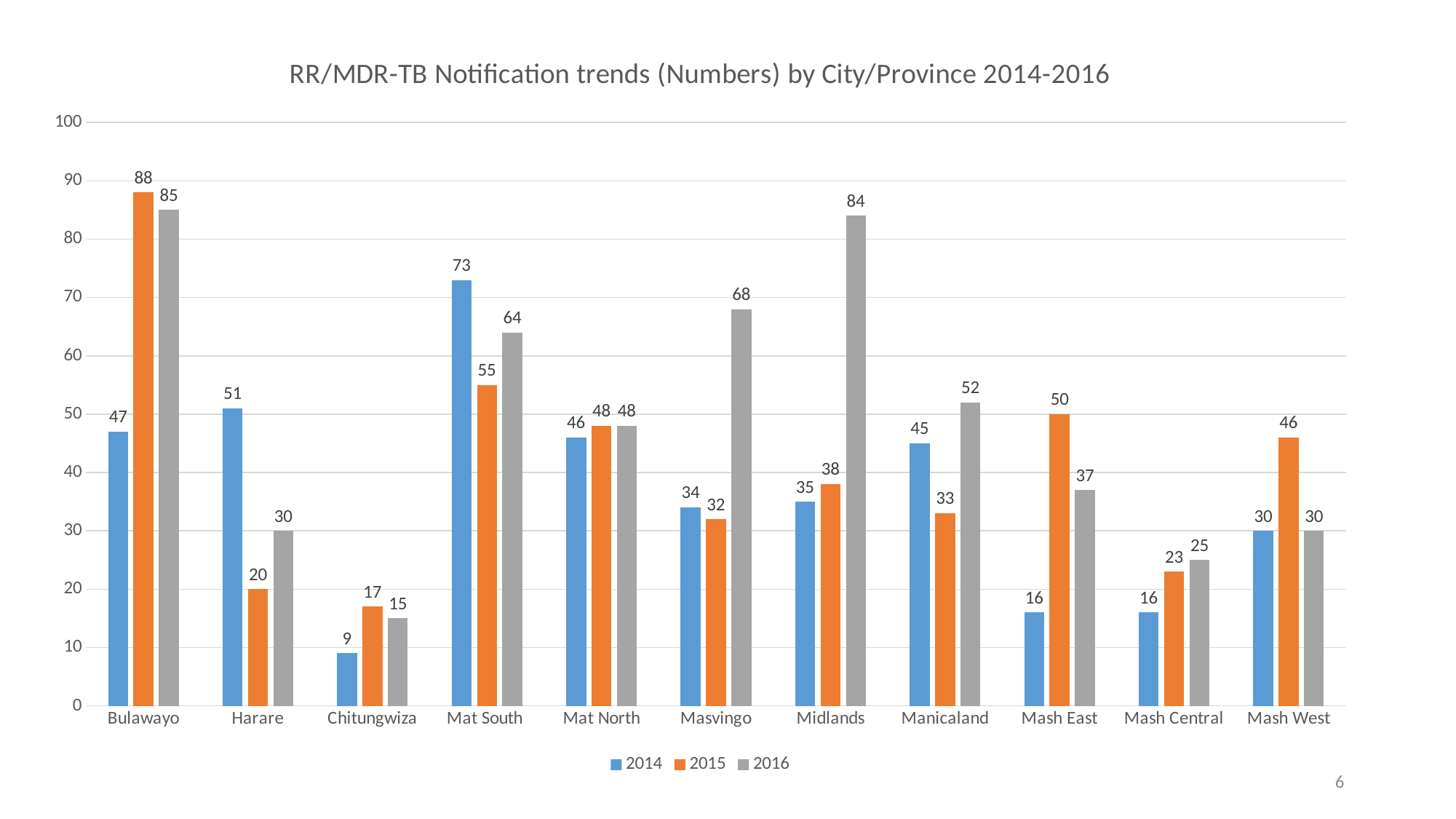
What is the 2016 value for Midlands? 84 How many series does the legend list? 3 Which city/province has the highest 2014 value? Mat South Which is larger for Harare: the 2014 value or the 2016 value? 2014 What is the 2015 value for Bulawayo? 88 How many cities/provinces are shown on the x axis? 11 What kind of chart is shown? Bar chart What is the 2014 value for Chitungwiza? 9 What is the difference between the 2016 and 2014 values for Midlands? 49 Which city/province has the lowest 2016 value? Chitungwiza What is the title of the chart? RR/MDR-TB Notification trends (Numbers) by City/Province 2014-2016 Do the values for Mash Central rise or fall from 2014 to 2016? Rise